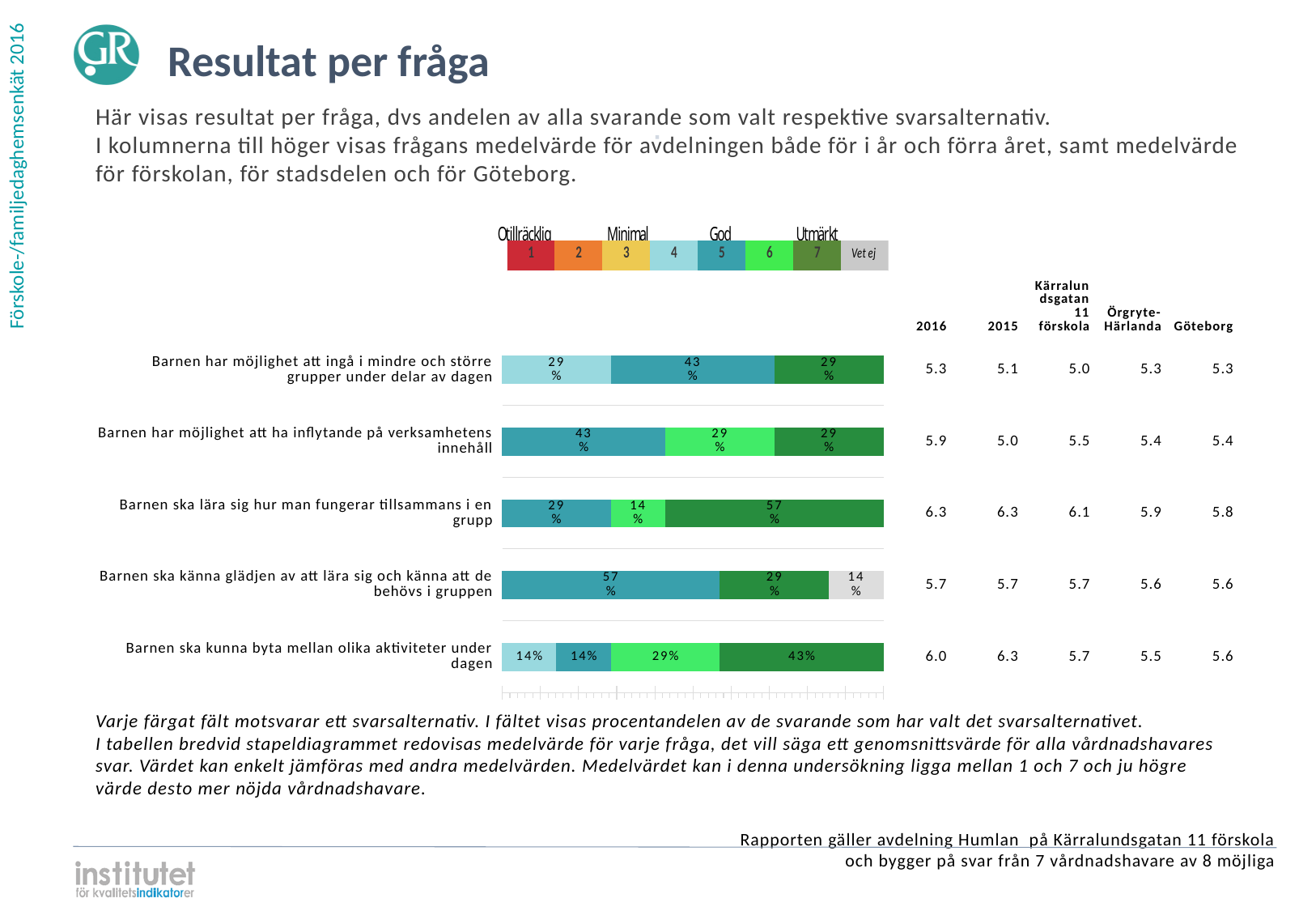
What kind of chart is used to show the results per question? Stacked bar chart For "Barnen ska lära sig hur man fungerar tillsammans i en grupp", what is the difference between the option 7 share and the option 6 share? 43 percentage points What percentage of respondents chose option 7 (dark green) for "Barnen ska lära sig hur man fungerar tillsammans i en grupp"? 57% How many questions (bars) are shown in the chart? 5 Which colour in the legend represents the response option "Vet ej"? Grey Which question has the largest share of respondents choosing option 7 (dark green)? Barnen ska lära sig hur man fungerar tillsammans i en grupp What is the combined share of options 6 and 7 for "Barnen ska kunna byta mellan olika aktiviteter under dagen"? 72% What percentage of respondents chose option 5 (teal) for "Barnen ska känna glädjen av att lära sig och känna att de behövs i gruppen"? 57% For "Barnen har möjlighet att ha inflytande på verksamhetens innehåll", which is larger: the share for option 5 (teal) or the share for option 6 (bright green)? Option 5 (43%) What percentage of respondents answered "Vet ej" for "Barnen ska känna glädjen av att lära sig och känna att de behövs i gruppen"? 14% What percentage of respondents chose option 7 (dark green) for "Barnen ska kunna byta mellan olika aktiviteter under dagen"? 43% How many response options does the colour legend above the chart list? 8